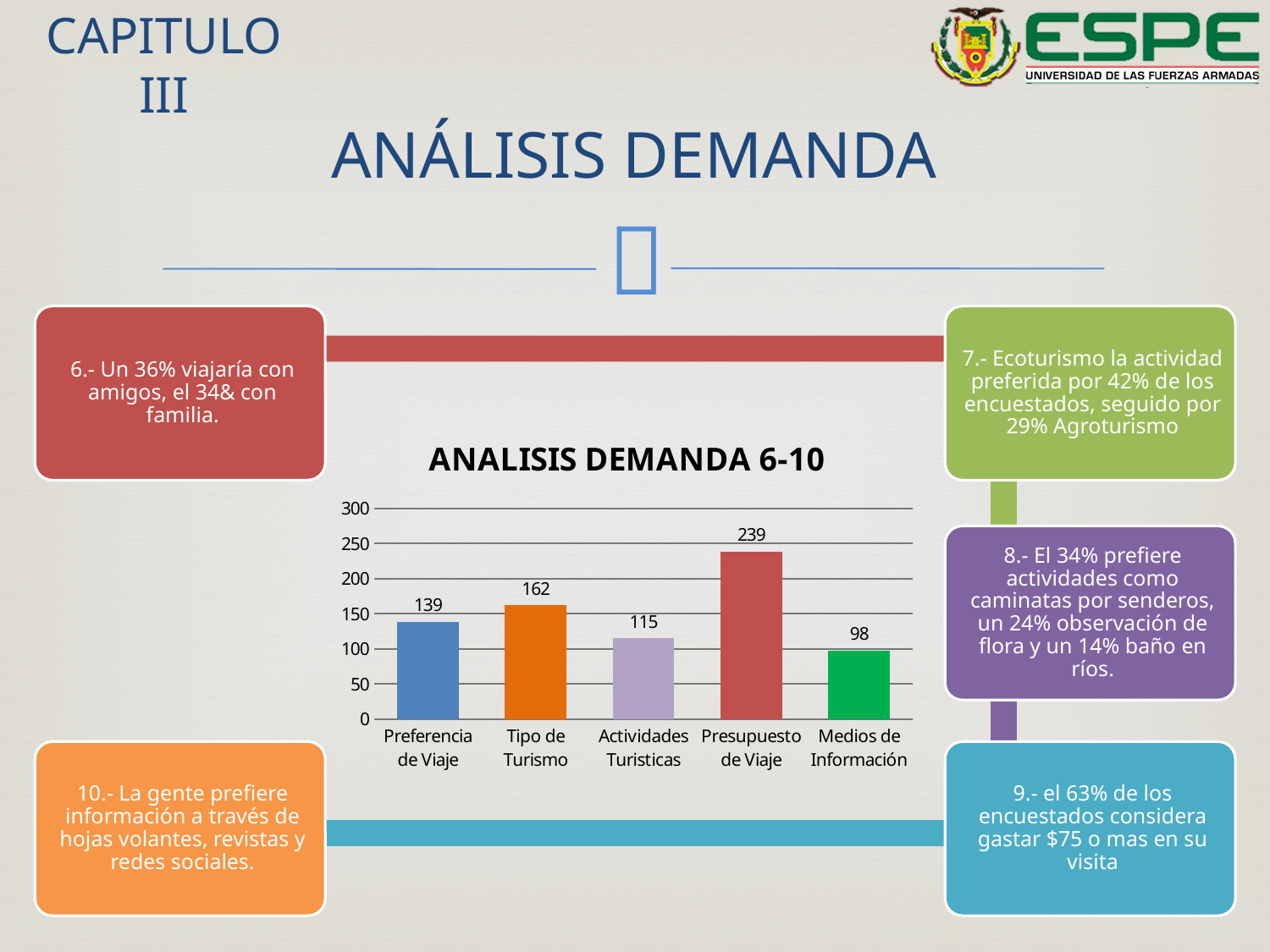
What kind of chart is shown on the slide? bar chart Which category has the highest value? Presupuesto de Viaje What is the title of the chart? ANALISIS DEMANDA 6-10 Which category has the lowest value? Medios de Información What is the value for Tipo de Turismo? 162 What is the value for Preferencia de Viaje? 139 How many categories are shown on the chart? 5 What is the value for Medios de Información? 98 What is the value for Actividades Turisticas? 115 Is the value for Presupuesto de Viaje greater or less than 200? greater What is the difference between the values for Presupuesto de Viaje and Tipo de Turismo? 77 Which is larger, the value for Preferencia de Viaje or the value for Actividades Turisticas? Preferencia de Viaje